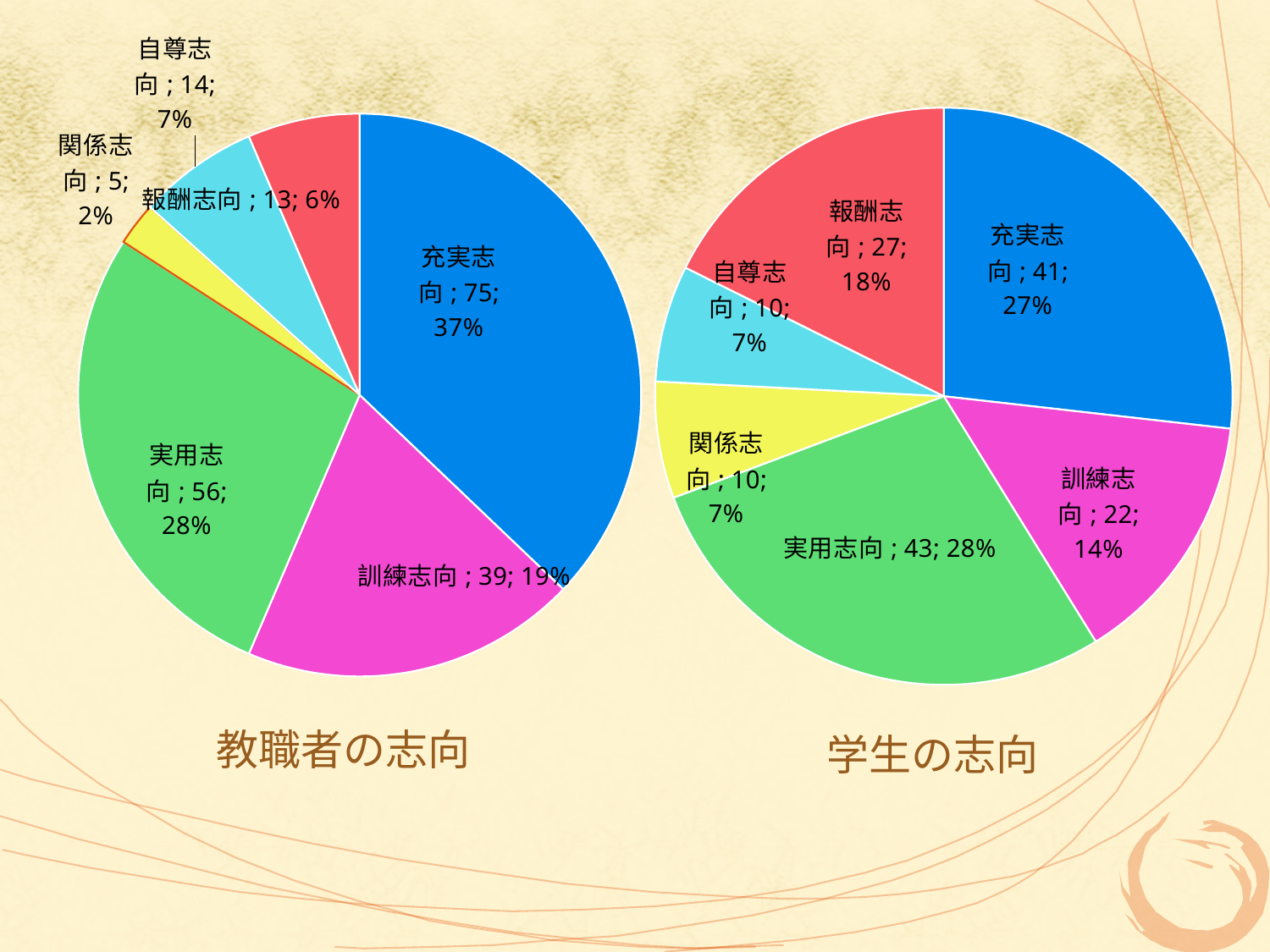
In the 学生の志向 chart, which category has the largest slice? 実用志向 In the 学生の志向 chart, what is the value for 報酬志向? 27 How many categories are shown in the 教職者の志向 chart? 6 In the 教職者の志向 chart, which category has the smallest slice? 関係志向 In the 教職者の志向 chart, what is the value for 充実志向? 75 In the 教職者の志向 chart, what share of the pie does 実用志向 take? 28% What type of chart is used for 学生の志向? Pie chart In the 学生の志向 chart, what is the difference between the values for 実用志向 and 関係志向? 33 In the 学生の志向 chart, what share of the pie does 訓練志向 take? 14% In the 学生の志向 chart, which is larger, the value for 充実志向 or the value for 訓練志向? 充実志向 In the 教職者の志向 chart, which category has the largest slice? 充実志向 In the 教職者の志向 chart, what is the difference between the values for 充実志向 and 訓練志向? 36